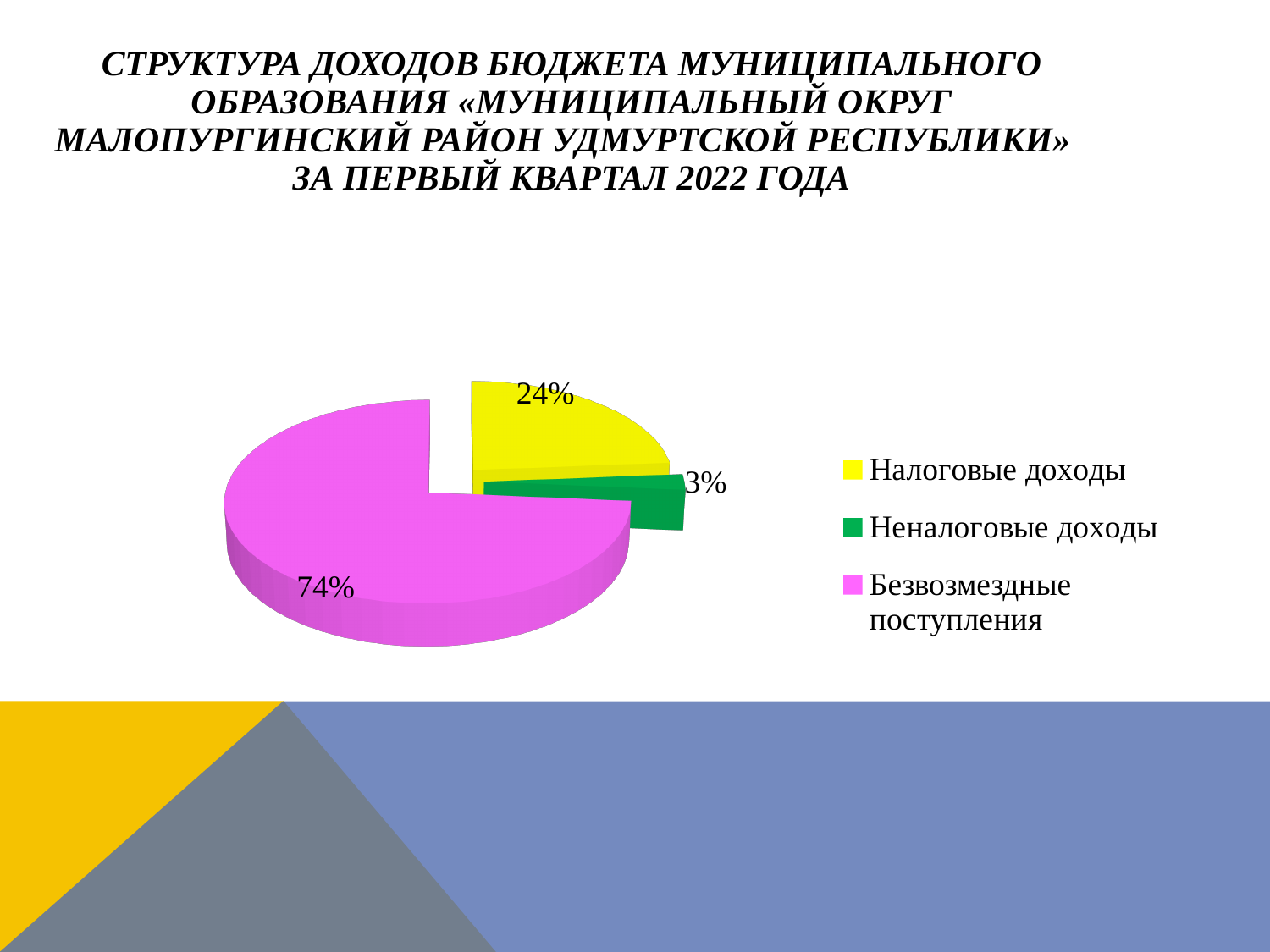
What colour is the slice for Безвозмездные поступления? Pink What is the difference in percentage points between Безвозмездные поступления and Налоговые доходы? 50 What kind of chart is shown on the slide? Pie chart What share of the pie does Безвозмездные поступления represent? 74% Which category has the smallest slice of the pie? Неналоговые доходы What share of the pie does Неналоговые доходы represent? 3% Which is larger, the share for Налоговые доходы or the share for Неналоговые доходы? Налоговые доходы What colour is the slice for Неналоговые доходы? Green What share of the pie does Налоговые доходы represent? 24% How many categories are shown in the pie chart? 3 What is the difference in percentage points between Налоговые доходы and Неналоговые доходы? 21 Which category has the largest slice of the pie? Безвозмездные поступления